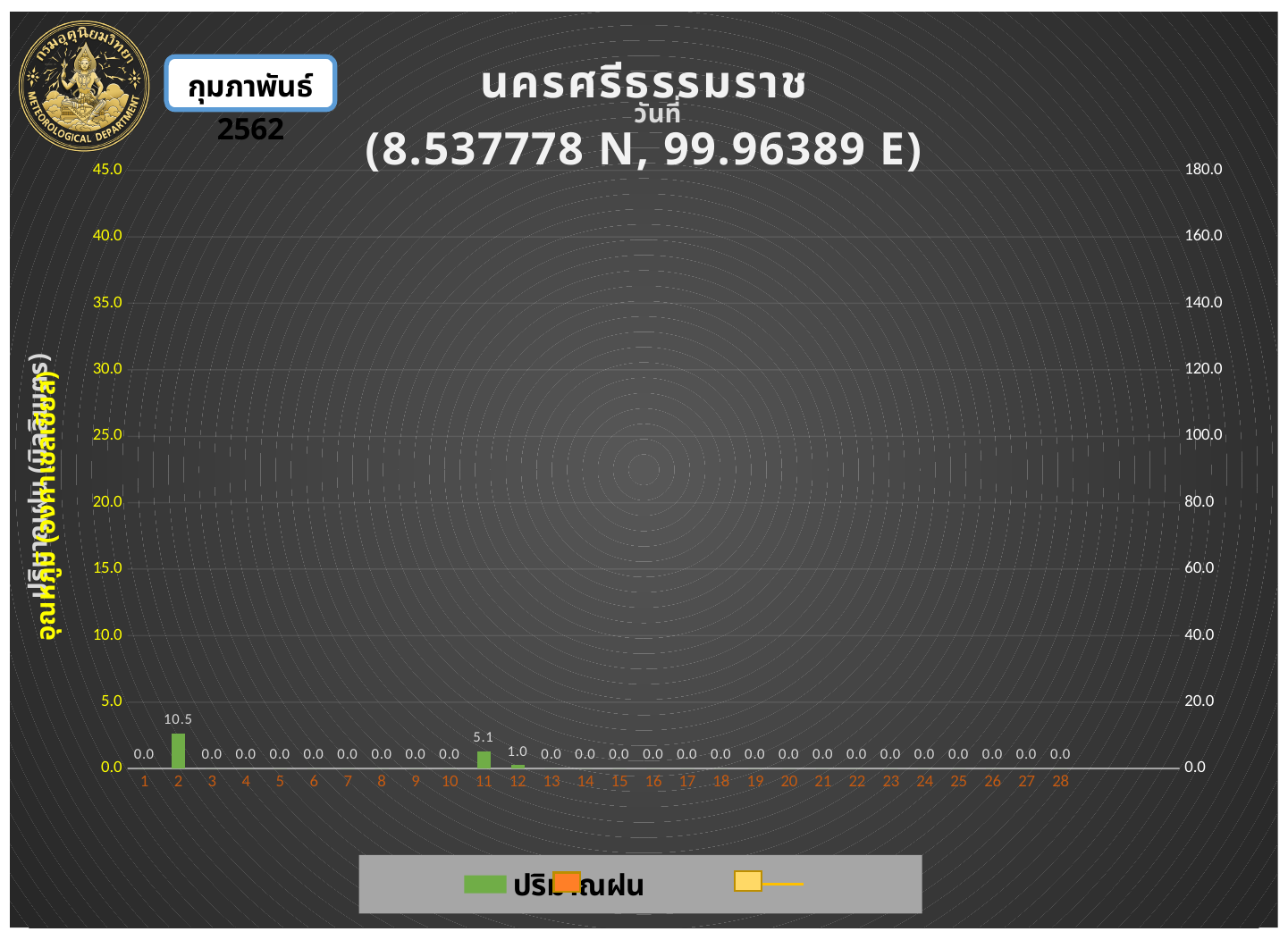
Which month and year are shown in the label at the top left of the chart? กุมภาพันธ์ 2562 What is the difference between the rainfall values for day 2 and day 11? 5.4 Which day has the larger rainfall value, day 11 or day 12? 11 Which day has the highest rainfall value? 2 What kind of chart is used to show the rainfall values? bar chart What is the rainfall value shown for day 12? 1.0 What is the difference between the rainfall values for day 11 and day 12? 4.1 How many days are shown on the x axis? 28 What is the rainfall value shown for day 11? 5.1 Is the rainfall value for day 2 greater or less than 20.0 on the right axis? less What is the rainfall value shown for day 20? 0.0 What is the rainfall value shown for day 2? 10.5